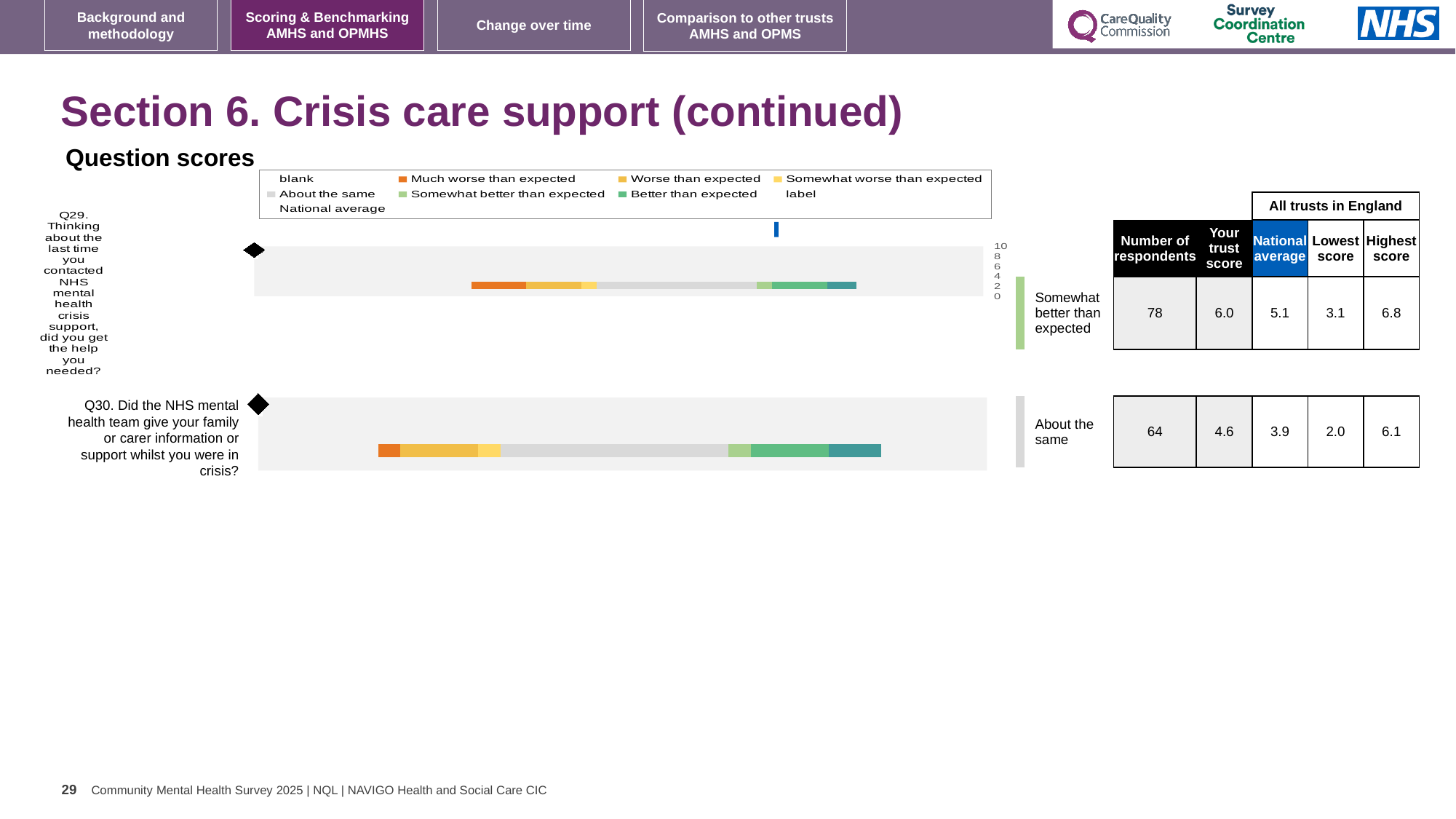
In the table to the right of the chart, what is the number of respondents for the Q29 row? 78 In the table to the right of the chart, what is the difference between the trust score and the national average for the Q30 row? 0.7 In the table to the right of the chart, which row has the higher trust score, Q29 or Q30? Q29 In the table to the right of the chart, what is the trust score for the Q30 row? 4.6 How many question bars are plotted in the chart? 2 What kind of chart is shown under 'Question scores'? bar chart In the table to the right of the chart, what is the highest score for the Q30 row? 6.1 In the table to the right of the chart, what is the national average for the Q29 row? 5.1 Which colour does the legend use for 'Much worse than expected'? orange What benchmark label is shown beside the Q30 bar? About the same Which colour does the legend use for 'Better than expected'? teal